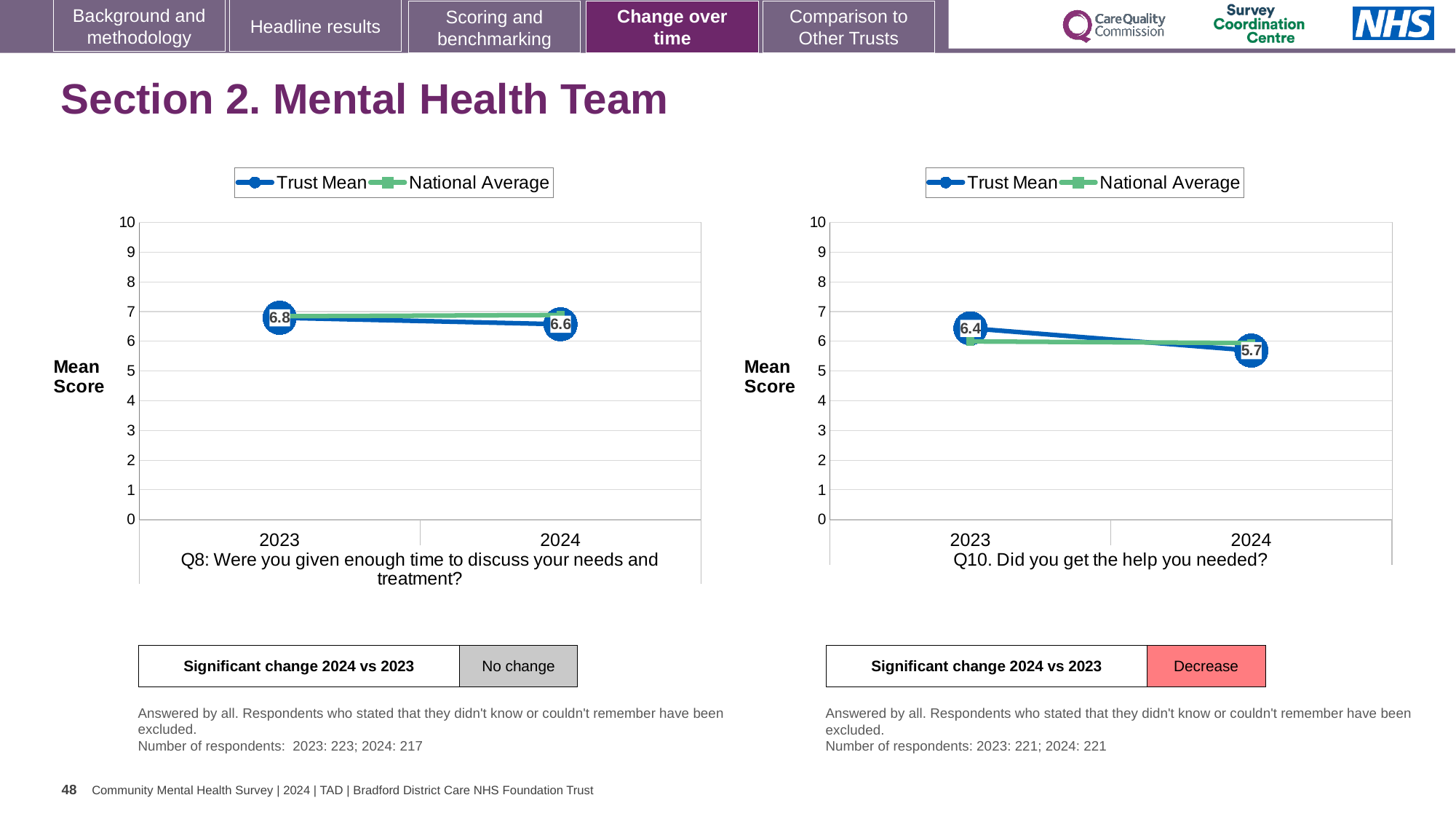
In the Q10 chart (right), by how much did the Trust Mean fall from 2023 to 2024? 0.7 In the Q10 chart (right), is the National Average for 2023 greater or less than 7? less In the Q10 chart (right), what is the Trust Mean for 2024? 5.7 How many years are shown on the x axis of the Q8 chart (left)? 2 How many series does the legend of the Q10 chart (right) list? 2 In the Q10 chart (right), which is larger in 2023: the Trust Mean or the National Average? Trust Mean In the Q10 chart (right), what is the Trust Mean for 2023? 6.4 In the Q10 chart (right), does the Trust Mean rise or fall from 2023 to 2024? fall What kind of chart is used for Q8 (left)? line chart In the Q8 chart (left), what is the Trust Mean for 2023? 6.8 In the Q8 chart (left), what is the Trust Mean for 2024? 6.6 In the Q8 chart (left), what is the difference between the Trust Mean in 2023 and in 2024? 0.2